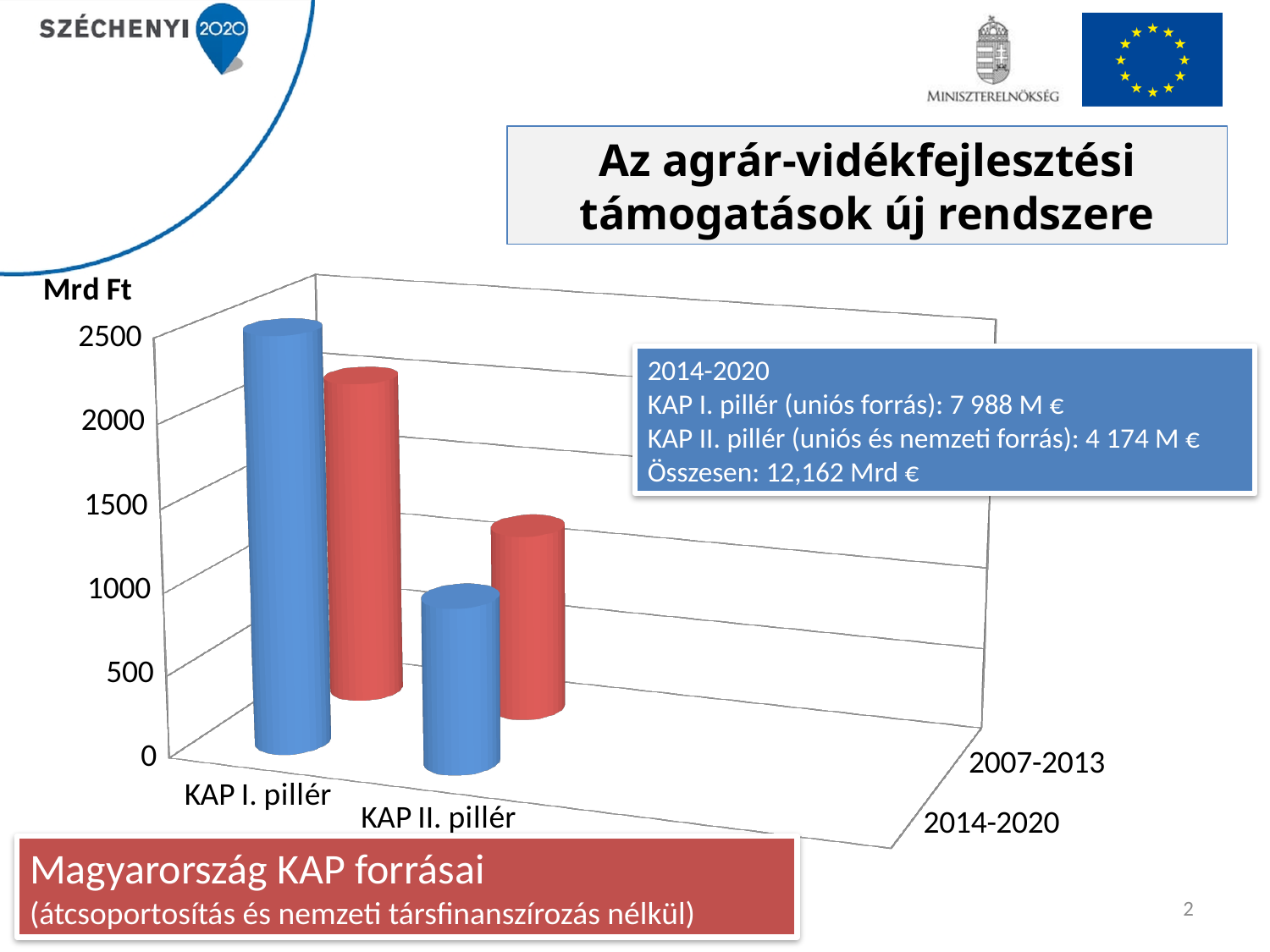
Which category has the highest bar in the chart? KAP I. pillér Is the value for KAP II. pillér in 2007-2013 greater or less than 1500? less Is the value for KAP I. pillér in 2014-2020 greater or less than 1500? greater Which category has the lowest bar in the chart? KAP II. pillér What is the title shown in the red box below the chart? Magyarország KAP forrásai What unit is shown on the vertical axis of the chart? Mrd Ft For the 2007-2013 period, which is larger: KAP I. pillér or KAP II. pillér? KAP I. pillér For the 2014-2020 period, which is larger: KAP I. pillér or KAP II. pillér? KAP I. pillér What kind of chart is shown on the slide? bar chart How many series (periods) does the chart plot? 2 How many categories are shown on the x axis of the chart? 2